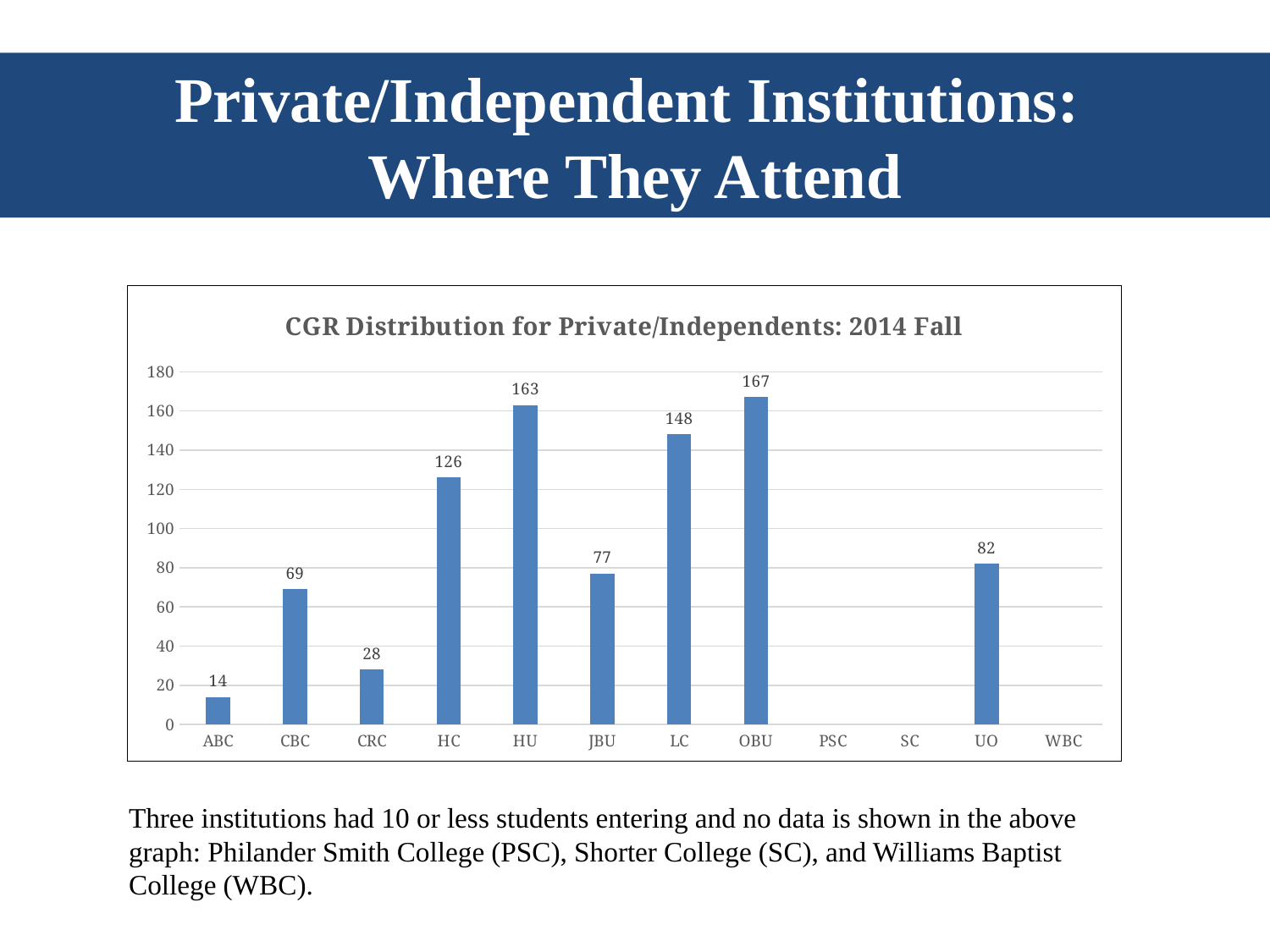
What is the value for CBC? 69 Among the institutions with a bar shown, which has the lowest value? ABC What is the difference between the values for LC and JBU? 71 What is the value for HU? 163 Which is larger, the value for HC or the value for LC? LC What kind of chart is shown? bar chart How many institutions are listed on the x axis? 12 What is the difference between the values for OBU and HU? 4 What is the title of the chart? CGR Distribution for Private/Independents: 2014 Fall Is the value for JBU greater or less than 100? less Which institution has the highest value? OBU What is the value for UO? 82